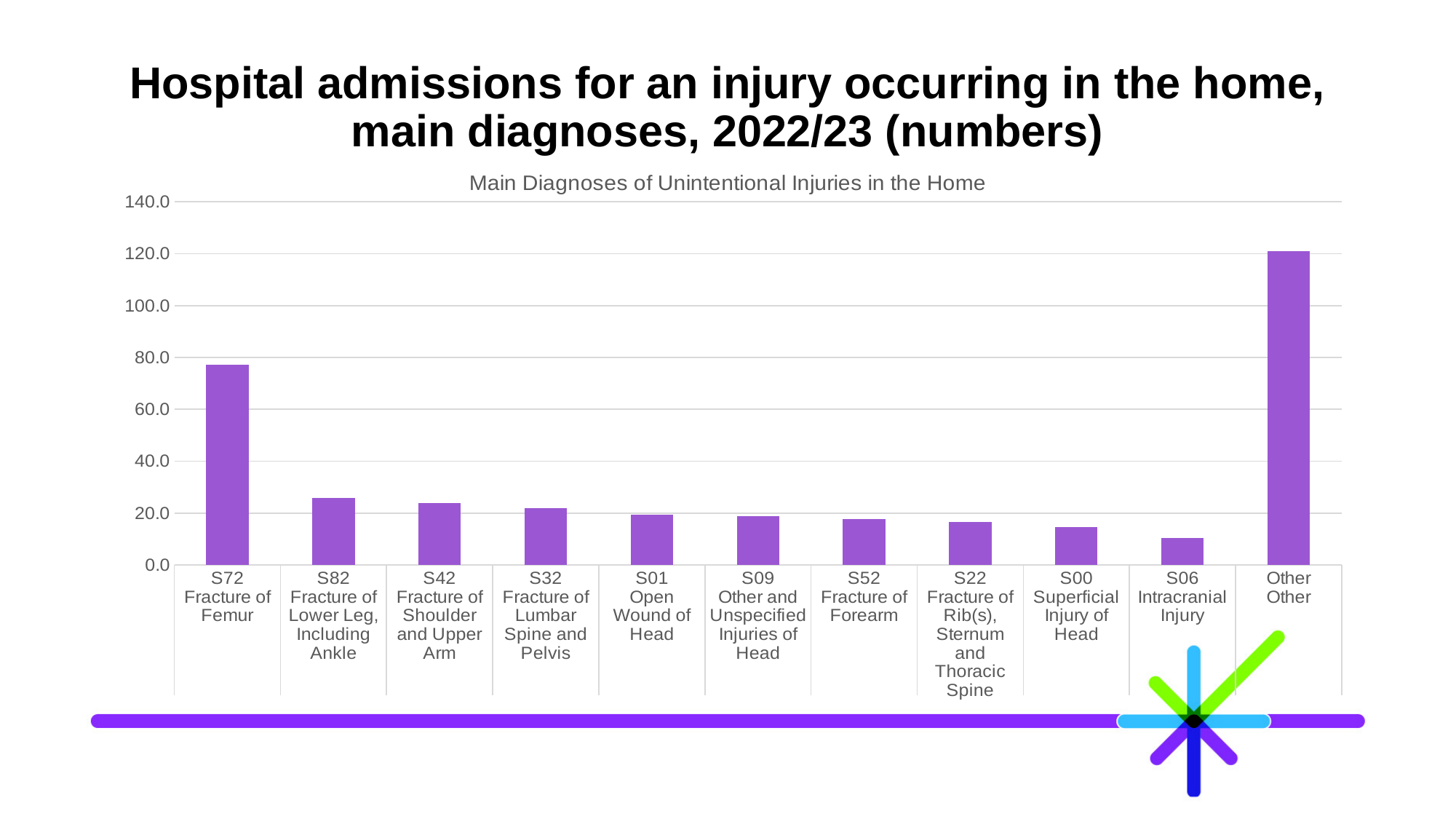
Is the value for S06 Intracranial Injury greater or less than 20? less Is the value for S72 Fracture of Femur greater or less than 60? greater What kind of chart is shown on the slide? Bar chart Which is larger, the value for S42 Fracture of Shoulder and Upper Arm or the value for S06 Intracranial Injury? S42 Fracture of Shoulder and Upper Arm Which is larger, the value for S72 Fracture of Femur or the value for S82 Fracture of Lower Leg, Including Ankle? S72 Fracture of Femur Is the value for S00 Superficial Injury of Head greater or less than 20? less Which category has the lowest value in the chart? S06 Intracranial Injury What is the subtitle shown directly above the chart area? Main Diagnoses of Unintentional Injuries in the Home Which category has the highest value in the chart? Other Other How many diagnosis categories are shown on the x axis? 11